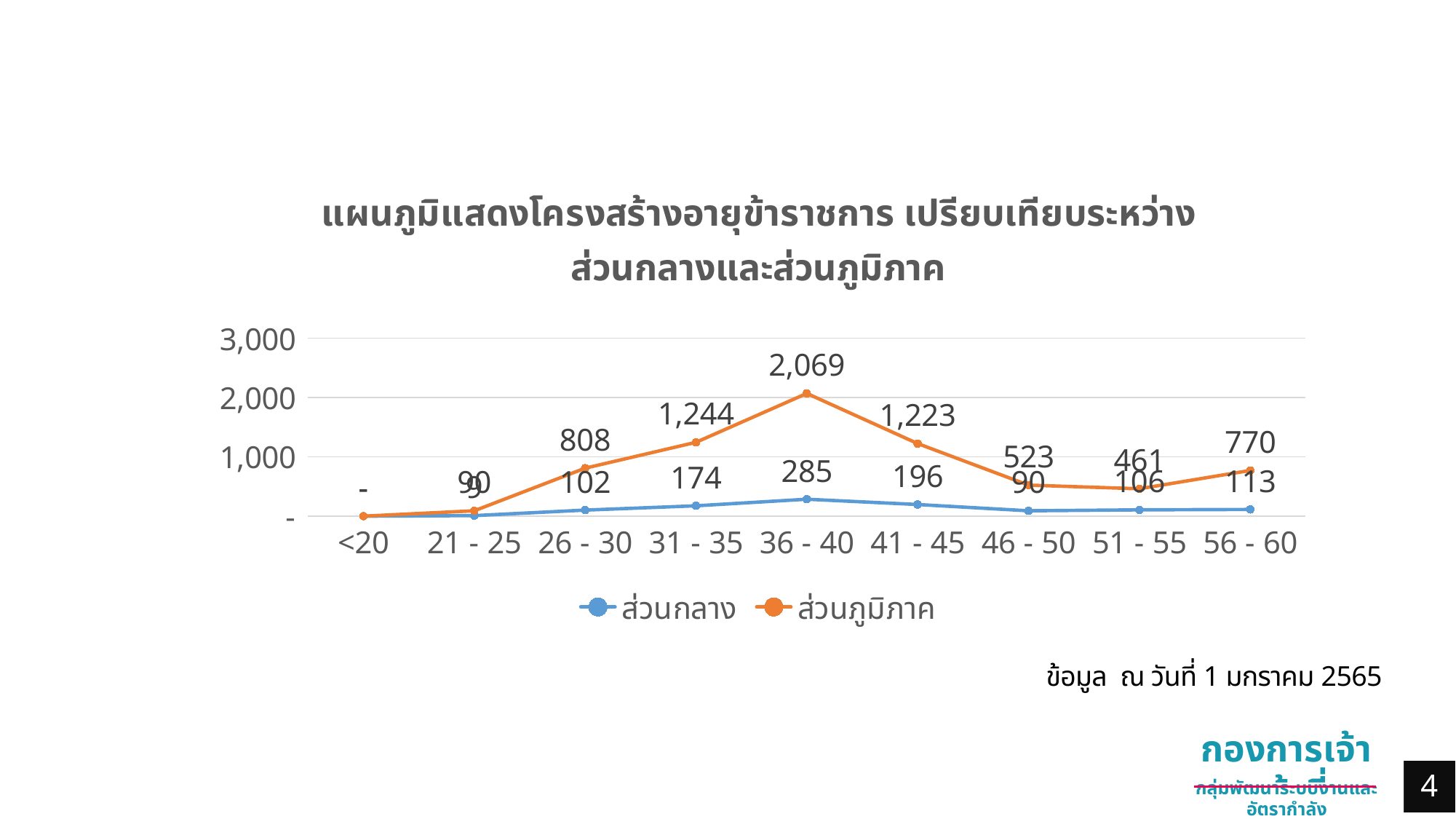
What kind of chart is shown on the slide? line chart What is the value for ส่วนภูมิภาค in the 56 - 60 age group? 770 How many series does the legend list? 2 What is the value for ส่วนภูมิภาค in the 36 - 40 age group? 2,069 Which is larger: the ส่วนภูมิภาค value for 46 - 50 or for 51 - 55? 46 - 50 What is the difference between the ส่วนภูมิภาค values for 31 - 35 and 41 - 45? 21 What is the value for ส่วนกลาง in the 46 - 50 age group? 90 Which series is drawn in orange? ส่วนภูมิภาค Which age group has the highest value for ส่วนภูมิภาค? 36 - 40 How many age-group categories are shown on the x axis? 9 Is the ส่วนภูมิภาค value for 36 - 40 greater or less than 2,000? greater What is the value for ส่วนกลาง in the 36 - 40 age group? 285